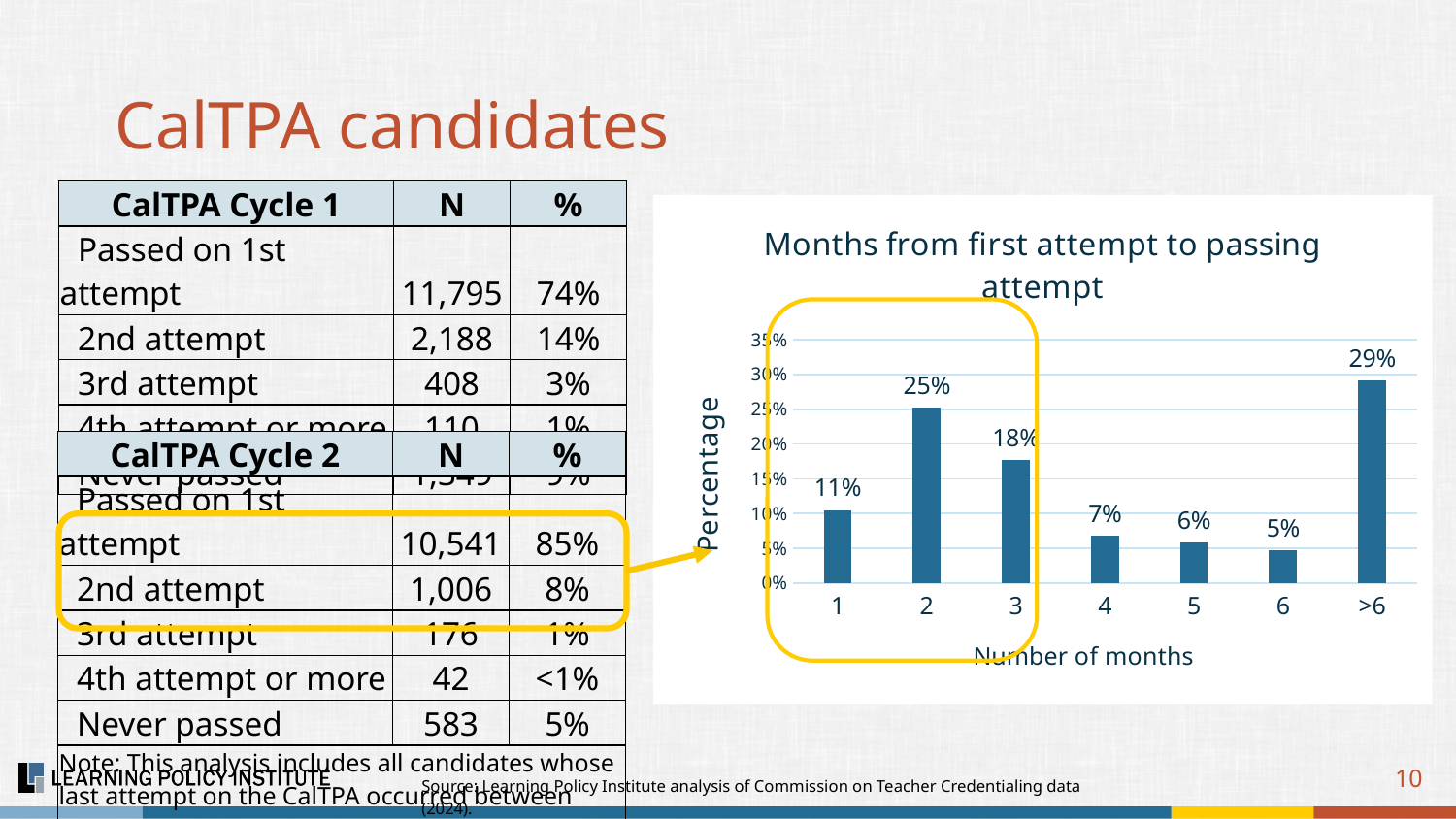
What kind of chart is shown on the slide? Bar chart Which number-of-months category has the highest percentage? >6 What is the value for 2 months in the chart? 25% What is the difference between the values for 2 months and 3 months? 7% What percentage of candidates passed more than 6 months after their first attempt? 29% What is the value for 4 months? 7% What is the label of the x axis of the chart? Number of months How many categories are shown on the x axis of the chart? 7 Which is larger, the value for 1 month or the value for 3 months? 3 months What is the title of the chart? Months from first attempt to passing attempt Is the value for 5 months greater or less than 10%? less Which number-of-months category has the lowest percentage? 6